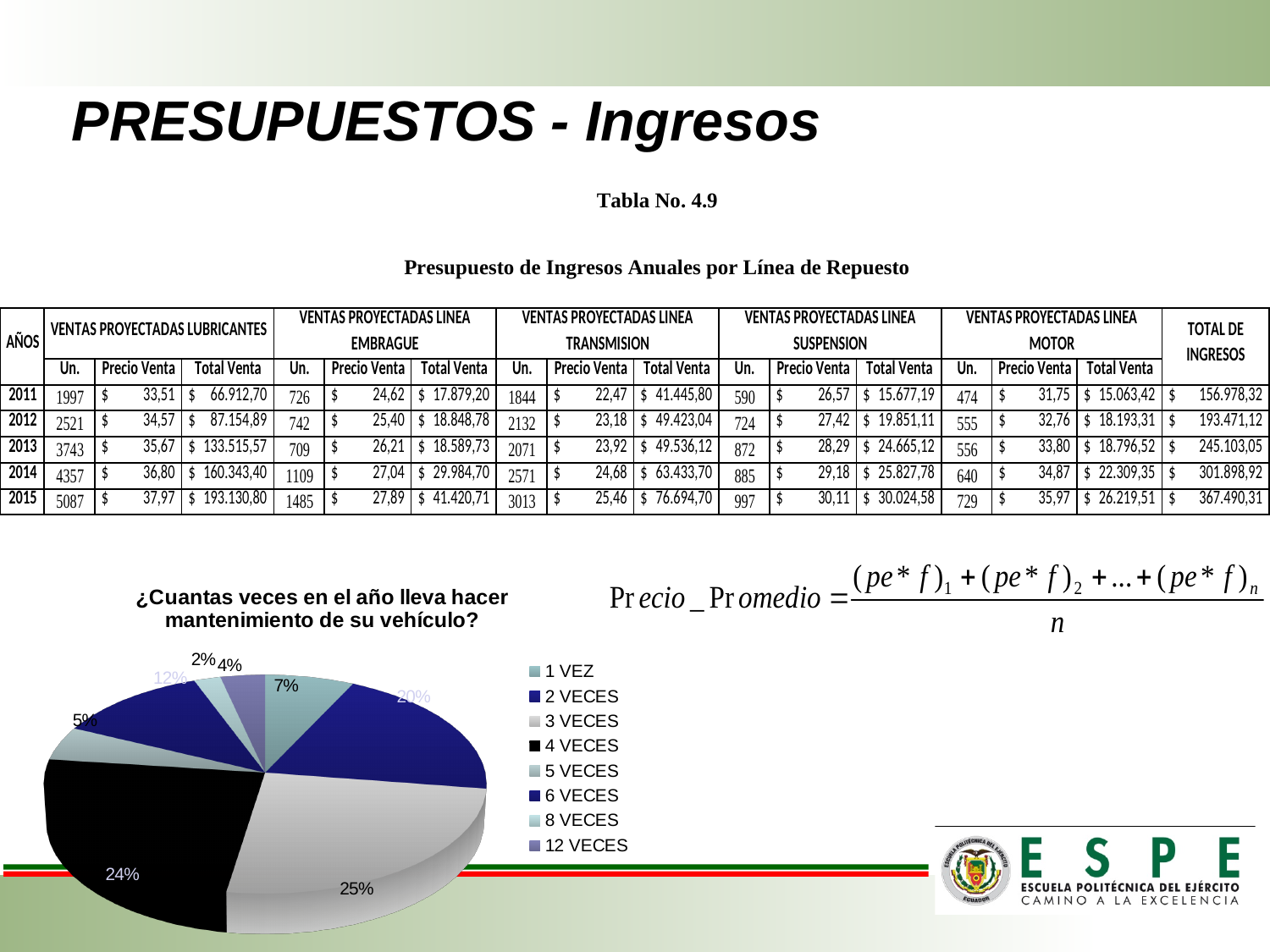
In the pie chart, what share is labelled for 1 VEZ? 7% What is the last entry listed in the pie chart's legend? 12 VECES What is the title of the pie chart? ¿Cuantas veces en el año lleva hacer mantenimiento de su vehículo? What is the smallest percentage labelled on the pie chart? 2% What kind of chart is shown at the bottom left of the slide? pie chart In the pie chart, what is the difference in percentage points between the 3 VECES slice and the 2 VECES slice? 5 Which category has the largest slice in the pie chart? 3 VECES In the pie chart, which slice is larger: 2 VECES or 1 VEZ? 2 VECES In the pie chart, what share is labelled for 4 VECES? 24% How many categories does the pie chart's legend list? 8 In the pie chart, what share is labelled for 2 VECES? 20%